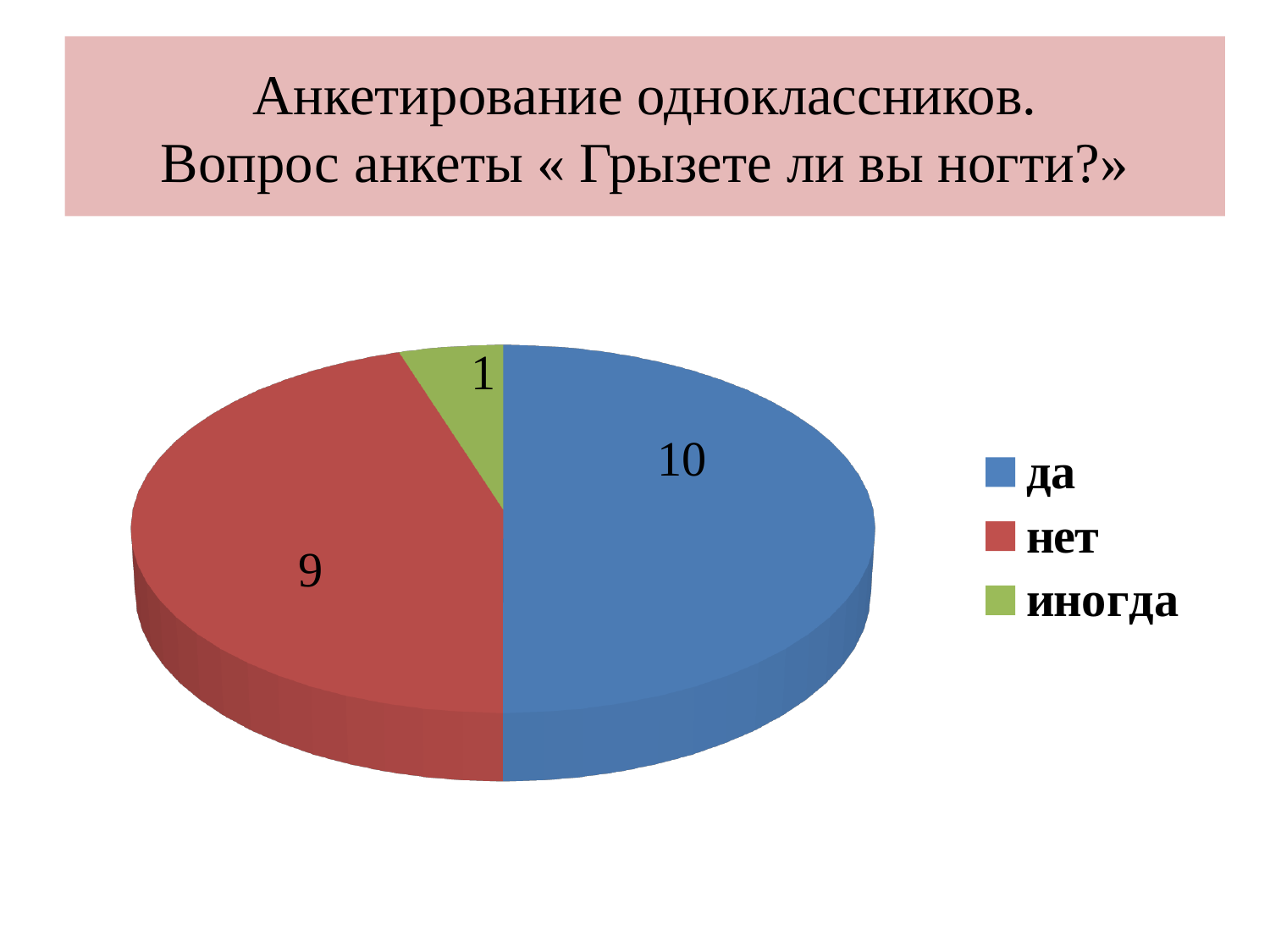
Which category has the smallest slice? иногда What share of the pie does "да" represent? 50% What colour is the slice for "нет"? red Which is larger, the value for "да" or the value for "иногда"? да What kind of chart is shown on the slide? pie chart How many categories does the pie chart have? 3 What is the difference between the values for "нет" and "иногда"? 8 Which category has the largest slice? да What is the difference between the values for "да" and "нет"? 1 What is the value for "нет"? 9 What is the value for "да"? 10 What is the value for "иногда"? 1